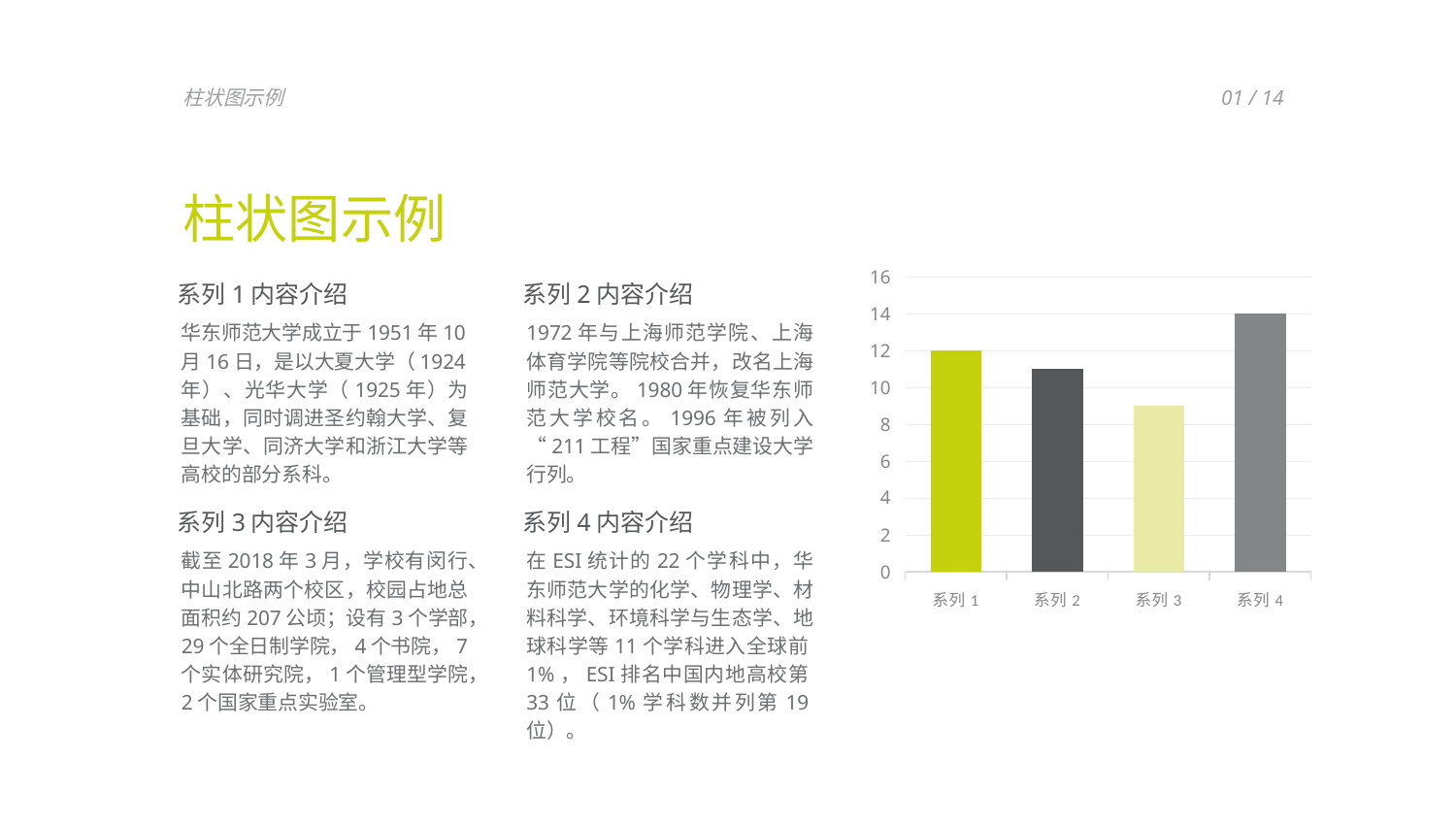
How many categories are plotted on the chart? 4 What is the difference between the values for 系列 4 and 系列 1? 2 Which category has the lowest value? 系列 3 What is the highest value shown on the vertical axis? 16 Is the value for 系列 3 greater or less than 10? less What is the title of the slide containing the chart? 柱状图示例 What is the value for 系列 1? 12 What is the value for 系列 4? 14 Which is larger, the value for 系列 4 or the value for 系列 3? 系列 4 Is the value for 系列 2 greater or less than 10? greater Which category has the highest value? 系列 4 What kind of chart is shown on the slide? bar chart